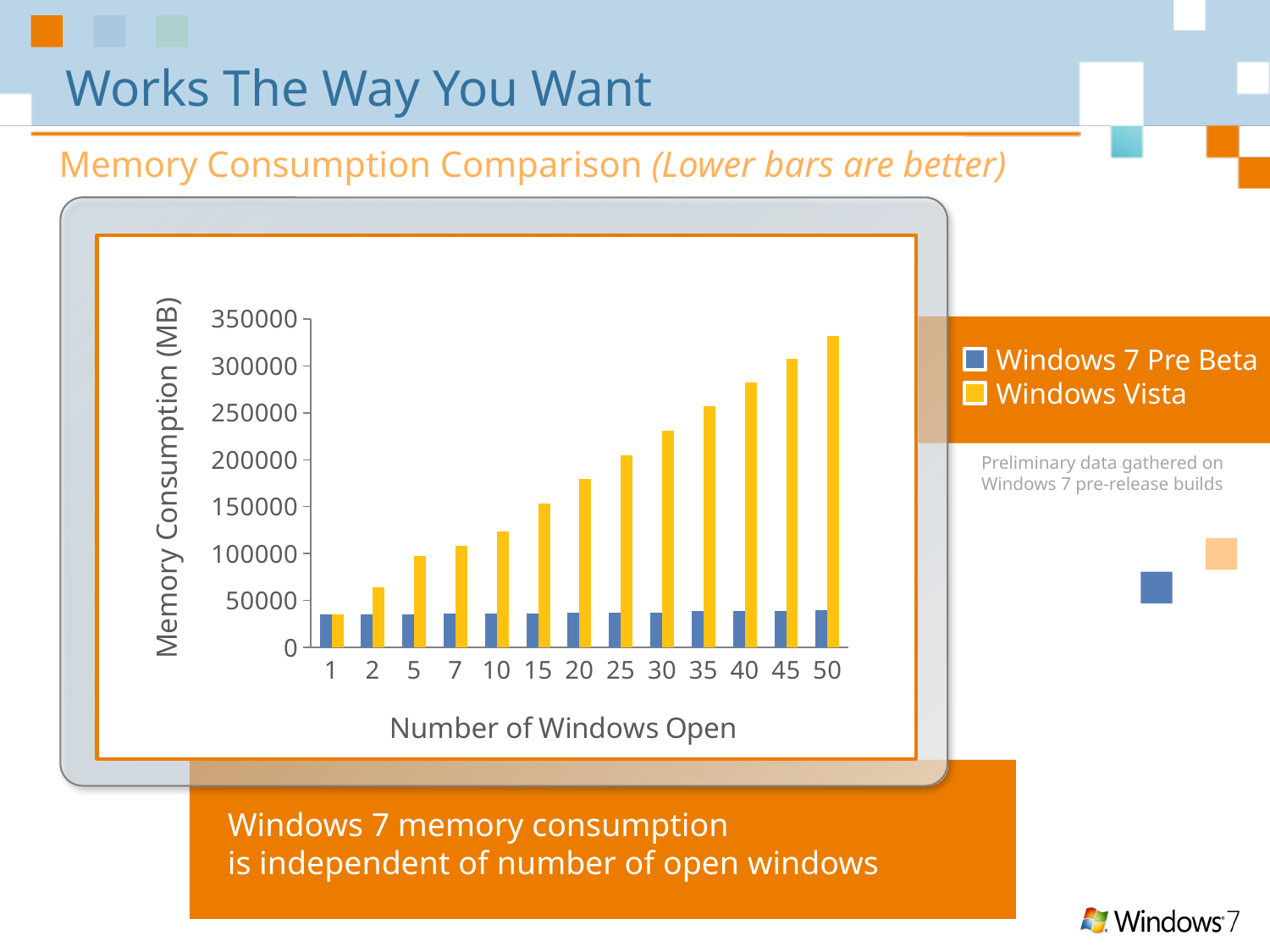
Is the Windows Vista value at 30 windows open greater or less than 200000? greater For which number of windows open is the Windows Vista bar lowest? 1 How many series does the chart's legend list? 2 At 50 windows open, which series has the larger memory consumption, Windows 7 Pre Beta or Windows Vista? Windows Vista Do the Windows Vista bars rise or fall as the number of windows open increases? rise For which number of windows open is the Windows Vista bar highest? 50 Is the Windows 7 Pre Beta value at 50 windows open greater or less than 50000? less What kind of chart is shown on the slide? bar chart Is the Windows Vista value at 50 windows open greater or less than 300000? greater What is the title of the chart's y axis? Memory Consumption (MB) How many categories are shown on the x axis of the chart? 13